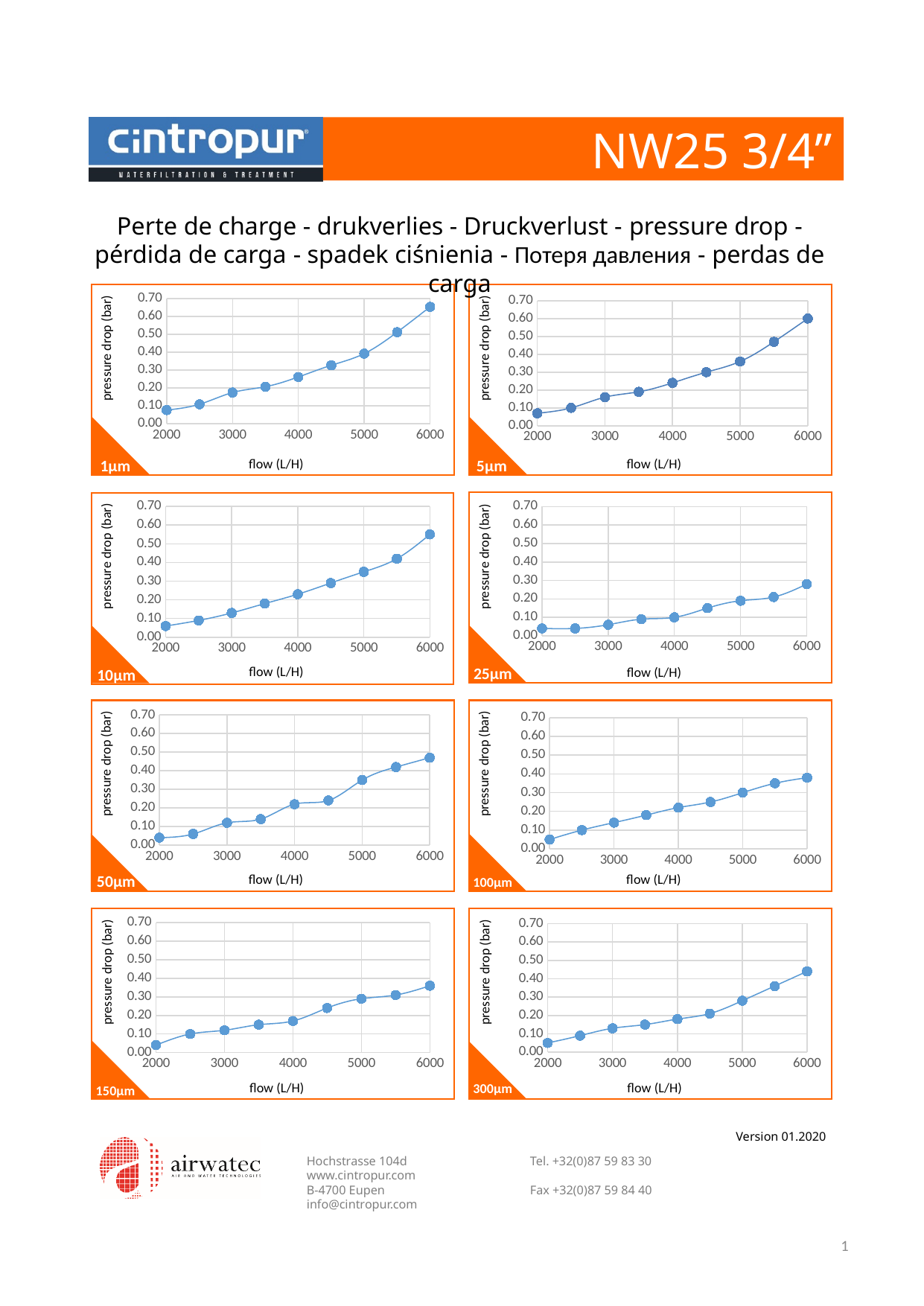
In the 1µm chart, is the pressure drop at a flow of 6000 L/H greater or less than 0.60? greater In the 300µm chart, is the pressure drop at a flow of 6000 L/H greater or less than 0.40? greater In the 10µm chart, is the pressure drop at a flow of 6000 L/H greater or less than 0.50? greater In the 5µm chart, does the pressure drop rise or fall as flow increases? rises In the 100µm chart, which flow value has the highest pressure drop? 6000 How many charts are shown on the slide? 8 What kind of chart is the 1µm chart? line chart How many data points are plotted in the 100µm chart? 9 What is the y-axis label of the 25µm chart? pressure drop (bar)